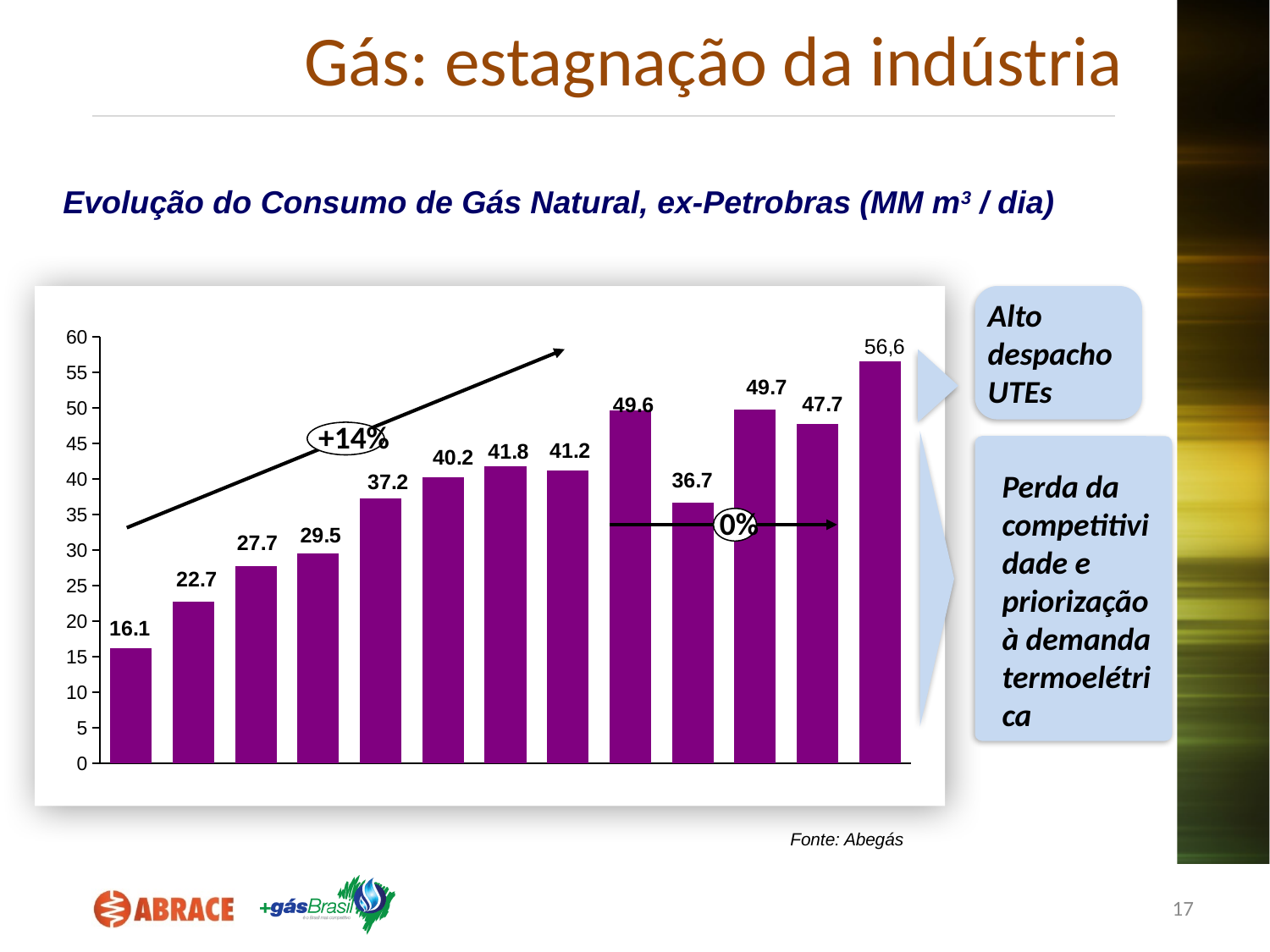
What is the value shown on the fifth bar from the left? 37.2 What is the value shown on the first (leftmost) bar of the chart? 16.1 What growth percentage is written in the oval annotation over the rising arrow on the left part of the chart? +14% What kind of chart is shown on the slide? bar chart Which bar has the highest value in the chart? the last (rightmost) bar, 56,6 Do the values generally rise or fall across the first five bars of the chart? rise What is the value shown on the last (rightmost) bar of the chart? 56,6 How many bars are plotted in the chart? 13 Which bar has the lowest value in the chart? the first (leftmost) bar, 16.1 What is the value shown on the tenth bar from the left, the one that dips below its neighbours? 36.7 What is the difference between the second bar (22.7) and the first bar (16.1)? 6.6 Which is larger, the ninth bar (49.6) or the eleventh bar (49.7)? the eleventh bar (49.7)